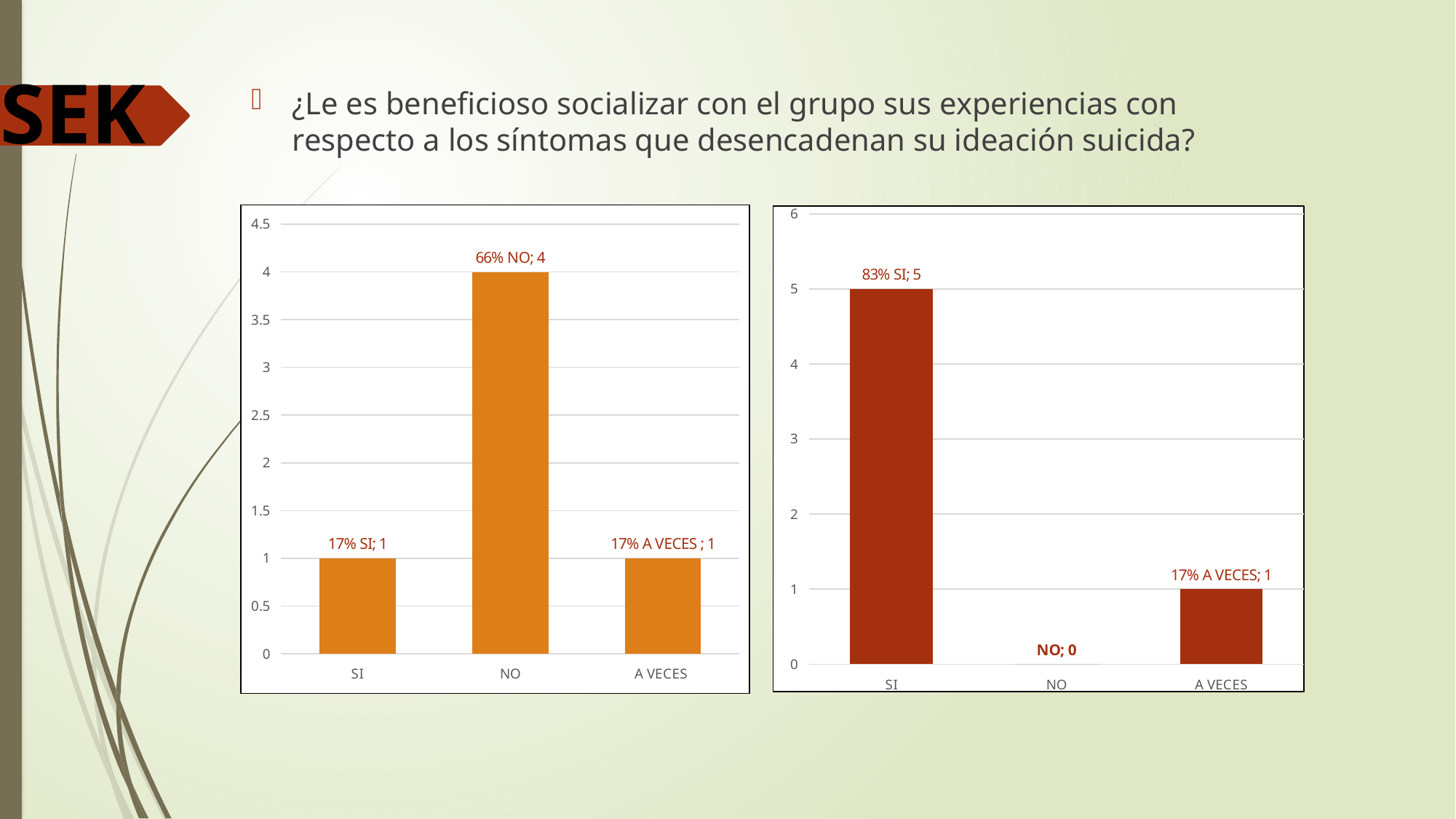
In the right chart, what is the value for NO? 0 In the right chart, which category has the lowest value? NO In the left chart, what is the difference between the values for NO and SI? 3 In the left chart, what is the value for NO? 4 In the left chart, which category has the highest value? NO In the left chart, what is the value for SI? 1 What type of chart is the right chart? bar chart In the right chart, which is larger, the value for SI or the value for A VECES? SI In the right chart, what is the value for SI? 5 How many categories are shown in the left chart? 3 In the right chart, what is the difference between the values for SI and A VECES? 4 In the right chart, what percentage is shown in the data label for SI? 83%